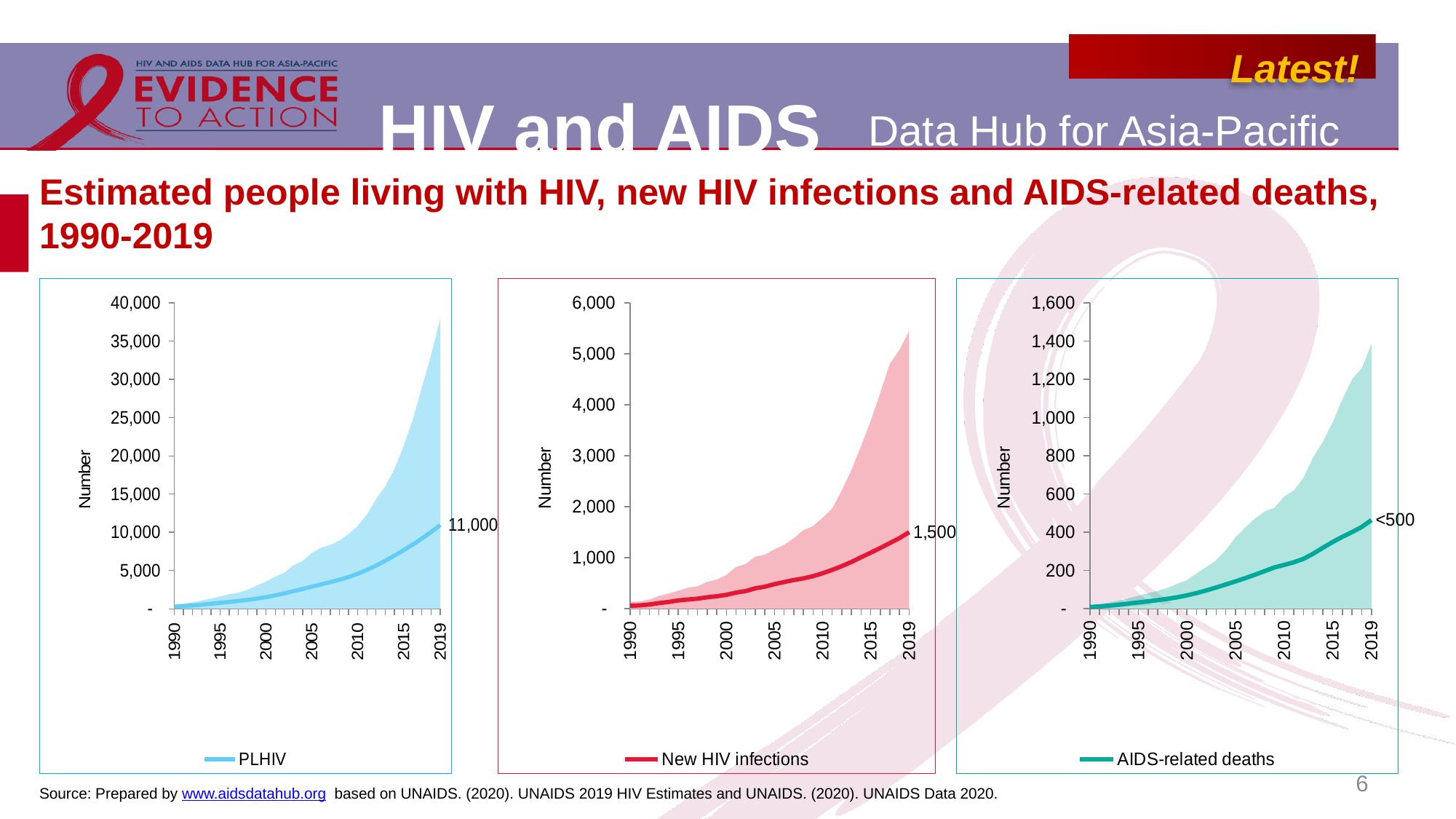
In the New HIV infections chart in the middle, what is the labelled value for 2019? 1,500 In the PLHIV chart on the left, is the value for 2015 greater or less than 10,000? less How many series does the legend of the middle chart list? 1 In the AIDS-related deaths chart on the right, what is the labelled value for 2019? <500 In the PLHIV chart on the left, what is the labelled value for 2019? 11,000 In the PLHIV chart on the left, do the values rise or fall from 1990 to 2019? rise In the AIDS-related deaths chart on the right, do the values rise or fall from 1990 to 2019? rise What is the legend entry of the chart on the right? AIDS-related deaths What kind of chart is the PLHIV chart on the left? combination area and line chart In the New HIV infections chart in the middle, is the value for 2010 greater or less than 1,000? less In the New HIV infections chart in the middle, do the values rise or fall from 1990 to 2019? rise In the AIDS-related deaths chart on the right, is the value for 2015 greater or less than 200? greater